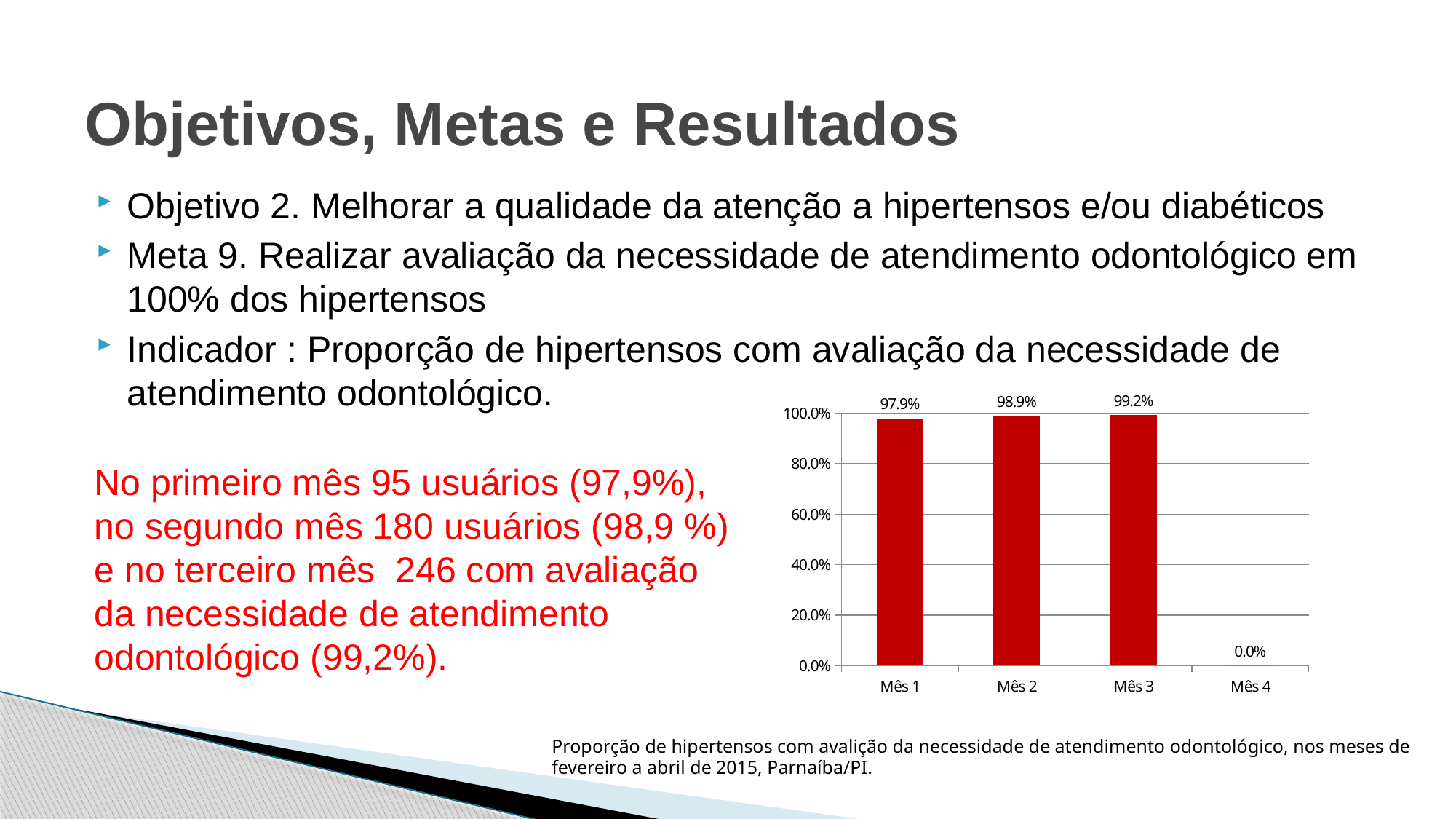
Which month has the lowest value? Mês 4 What kind of chart is shown on the slide? bar chart What is the value for Mês 3? 99.2% Do the values rise or fall from Mês 1 to Mês 3? rise Which month has the highest value? Mês 3 Is the value for Mês 2 greater or less than 80.0%? greater What is the value for Mês 2? 98.9% Which is larger, the value for Mês 1 or the value for Mês 3? Mês 3 What is the value for Mês 1? 97.9% What is the difference between the values for Mês 2 and Mês 1? 1.0% What is the value for Mês 4? 0.0% How many months are shown on the x axis of the chart? 4